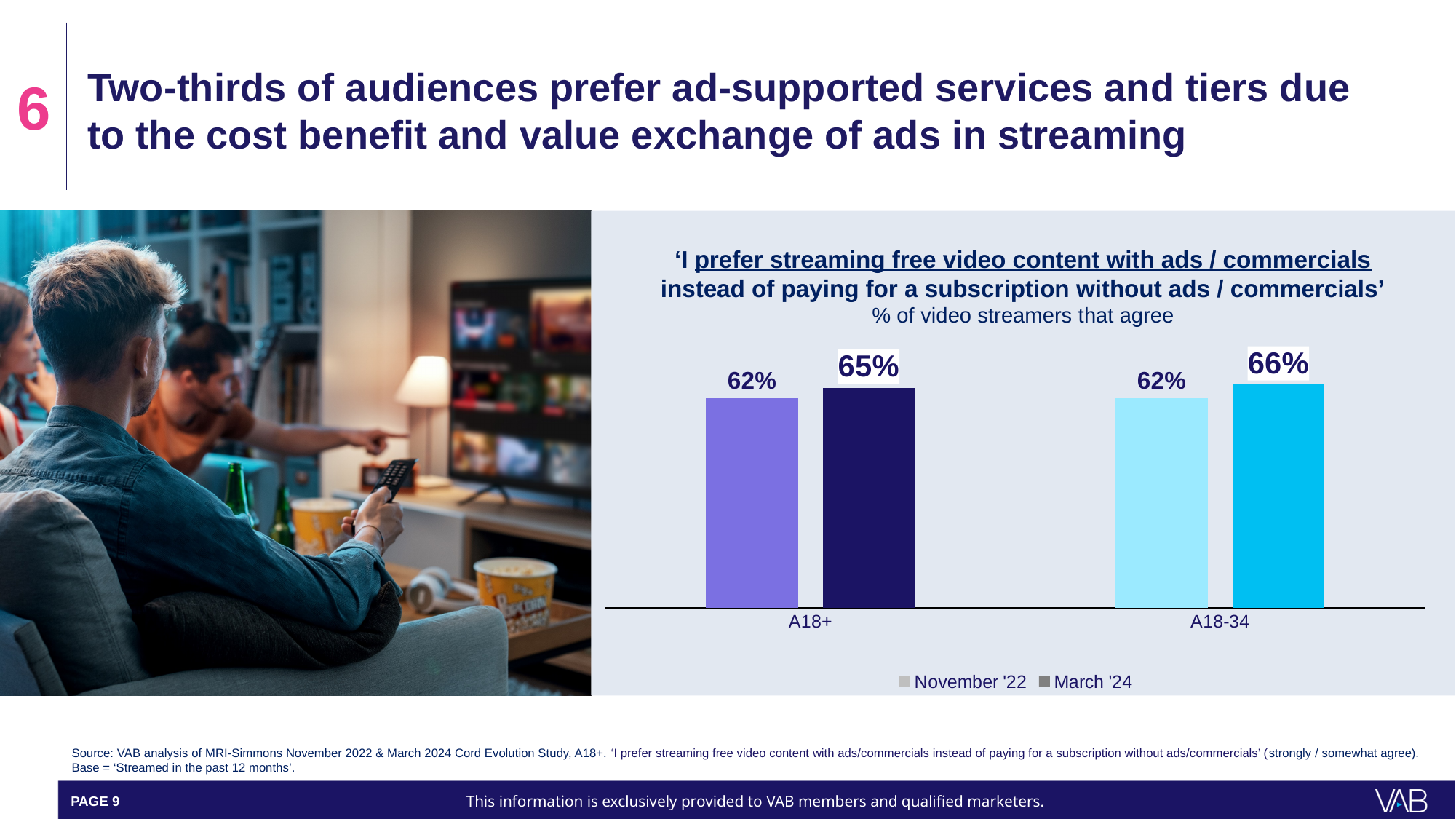
What are the two series named in the legend? November '22 and March '24 How many age groups are shown on the x axis? 2 What percentage of A18-34 video streamers agreed in March '24? 66% How many series does the legend list? 2 By how many percentage points did agreement among A18-34 change from November '22 to March '24? 4 percentage points What percentage of A18+ video streamers agreed in March '24? 65% What percentage of A18+ video streamers agreed in November '22? 62% What percentage of A18-34 video streamers agreed in November '22? 62% What kind of chart is shown on the slide? Bar chart By how many percentage points did agreement among A18+ change from November '22 to March '24? 3 percentage points Which is larger for March '24: the A18+ value or the A18-34 value? A18-34 Which bar shows the highest value on the chart? A18-34, March '24